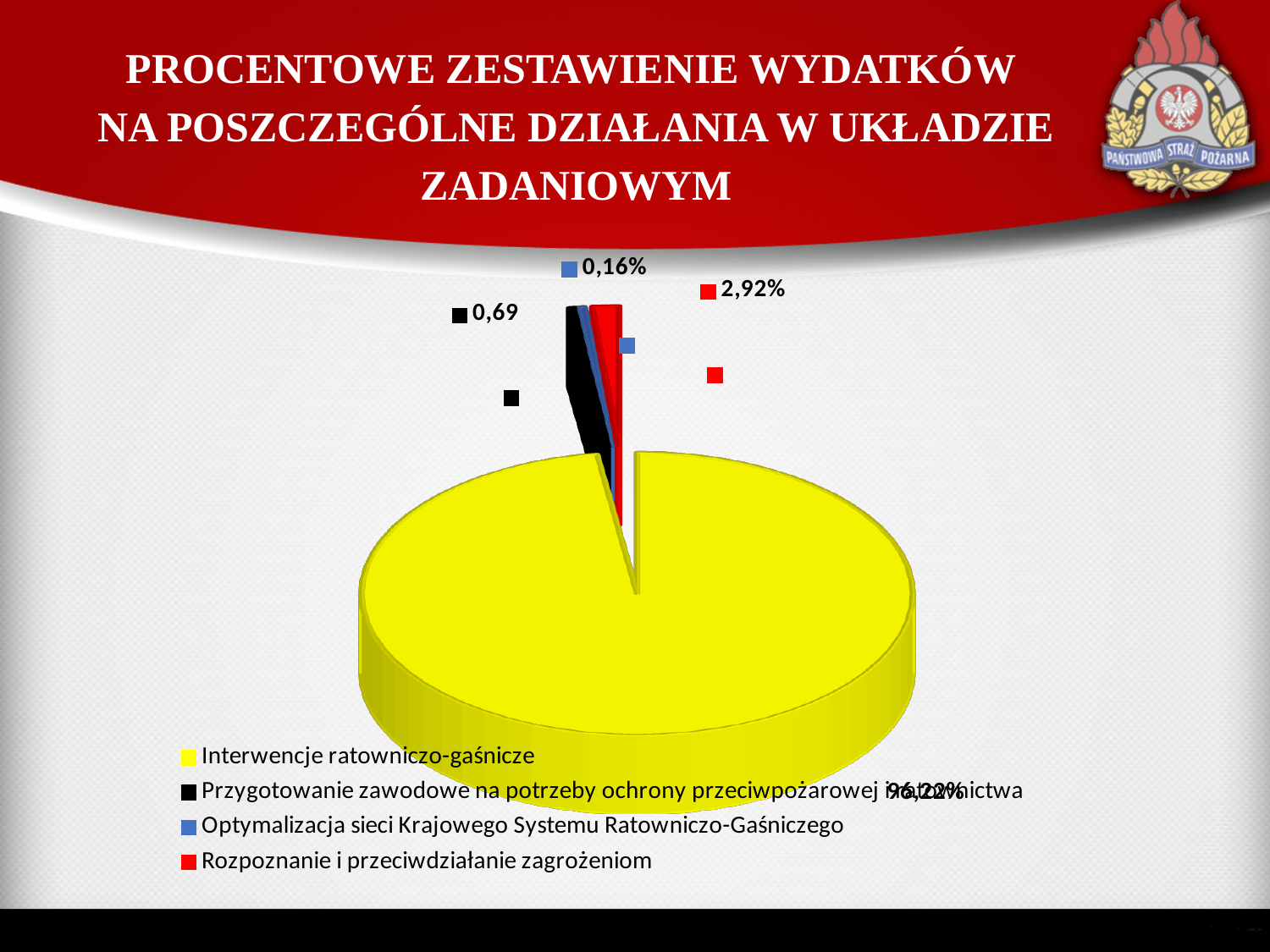
Which category has the largest share of the pie? Interwencje ratowniczo-gaśnicze How many slices does the pie chart have? 4 What value is shown for Rozpoznanie i przeciwdziałanie zagrożeniom? 2,92% Which is larger: Rozpoznanie i przeciwdziałanie zagrożeniom or Przygotowanie zawodowe na potrzeby ochrony przeciwpożarowej i ratownictwa? Rozpoznanie i przeciwdziałanie zagrożeniom Which category has the smallest share of the pie? Optymalizacja sieci Krajowego Systemu Ratowniczo-Gaśniczego What colour is the slice for Interwencje ratowniczo-gaśnicze? yellow What value is shown for Optymalizacja sieci Krajowego Systemu Ratowniczo-Gaśniczego? 0,16% What kind of chart is shown on the slide? pie chart How many entries does the legend list? 4 Which is larger: Optymalizacja sieci Krajowego Systemu Ratowniczo-Gaśniczego or Przygotowanie zawodowe na potrzeby ochrony przeciwpożarowej i ratownictwa? Przygotowanie zawodowe na potrzeby ochrony przeciwpożarowej i ratownictwa What is the difference between the values for Rozpoznanie i przeciwdziałanie zagrożeniom and Optymalizacja sieci Krajowego Systemu Ratowniczo-Gaśniczego? 2,76% What value is shown for Przygotowanie zawodowe na potrzeby ochrony przeciwpożarowej i ratownictwa? 0,69